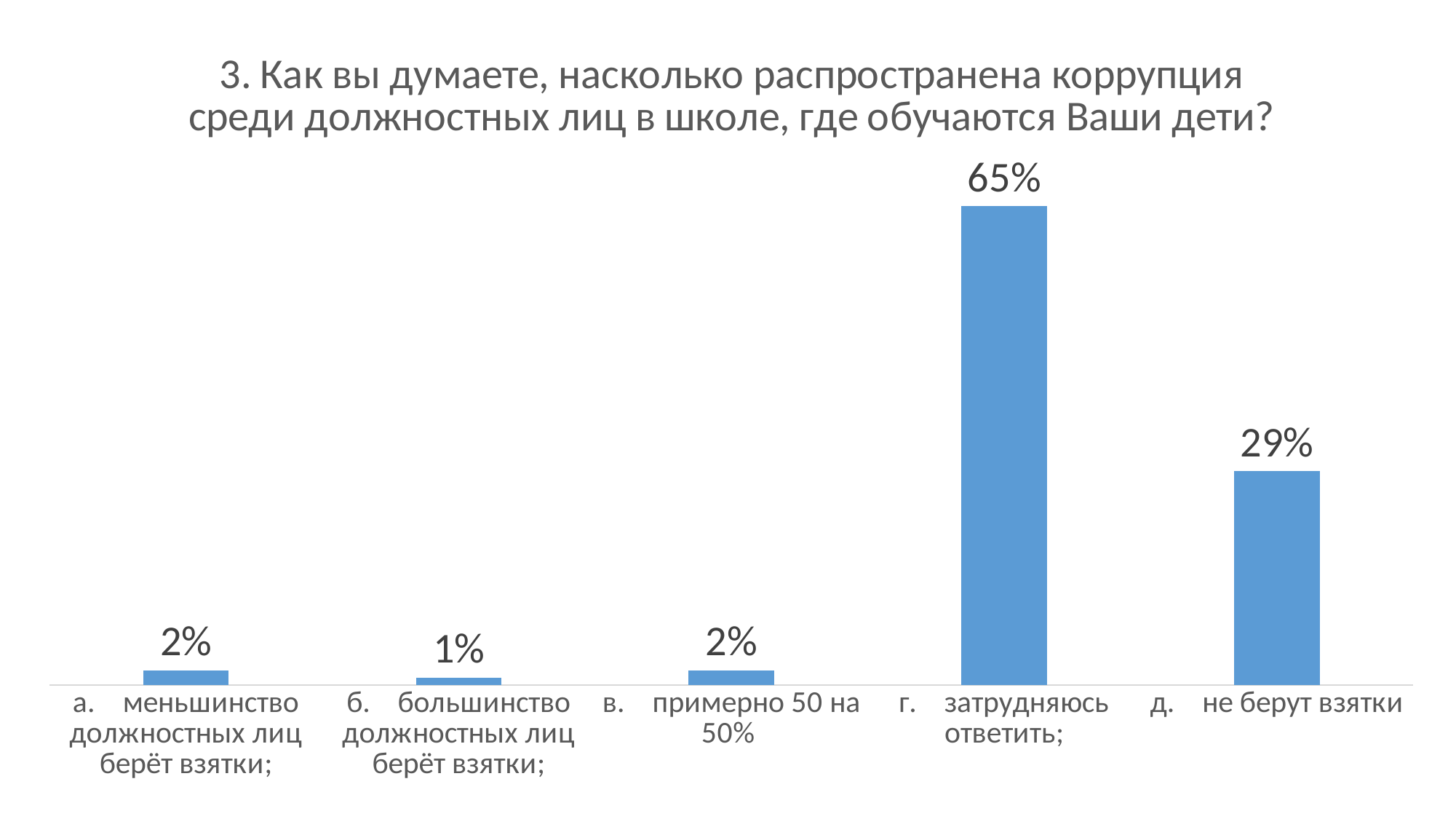
What is the difference between the values for "г. затрудняюсь ответить" and "д. не берут взятки"? 36% What value is shown for the category "д. не берут взятки"? 29% How many categories are shown in the chart? 5 What value is shown for the category "г. затрудняюсь ответить"? 65% What value is shown for the category "б. большинство должностных лиц берёт взятки"? 1% Which category has the highest value? г. затрудняюсь ответить What is the title of the chart? 3. Как вы думаете, насколько распространена коррупция среди должностных лиц в школе, где обучаются Ваши дети? Which category has the lowest value? б. большинство должностных лиц берёт взятки What kind of chart is shown on the slide? Bar chart What value is shown for the category "а. меньшинство должностных лиц берёт взятки"? 2% Which is larger: the value for "д. не берут взятки" or the value for "в. примерно 50 на 50%"? д. не берут взятки What is the difference between the values for "а. меньшинство должностных лиц берёт взятки" and "б. большинство должностных лиц берёт взятки"? 1%